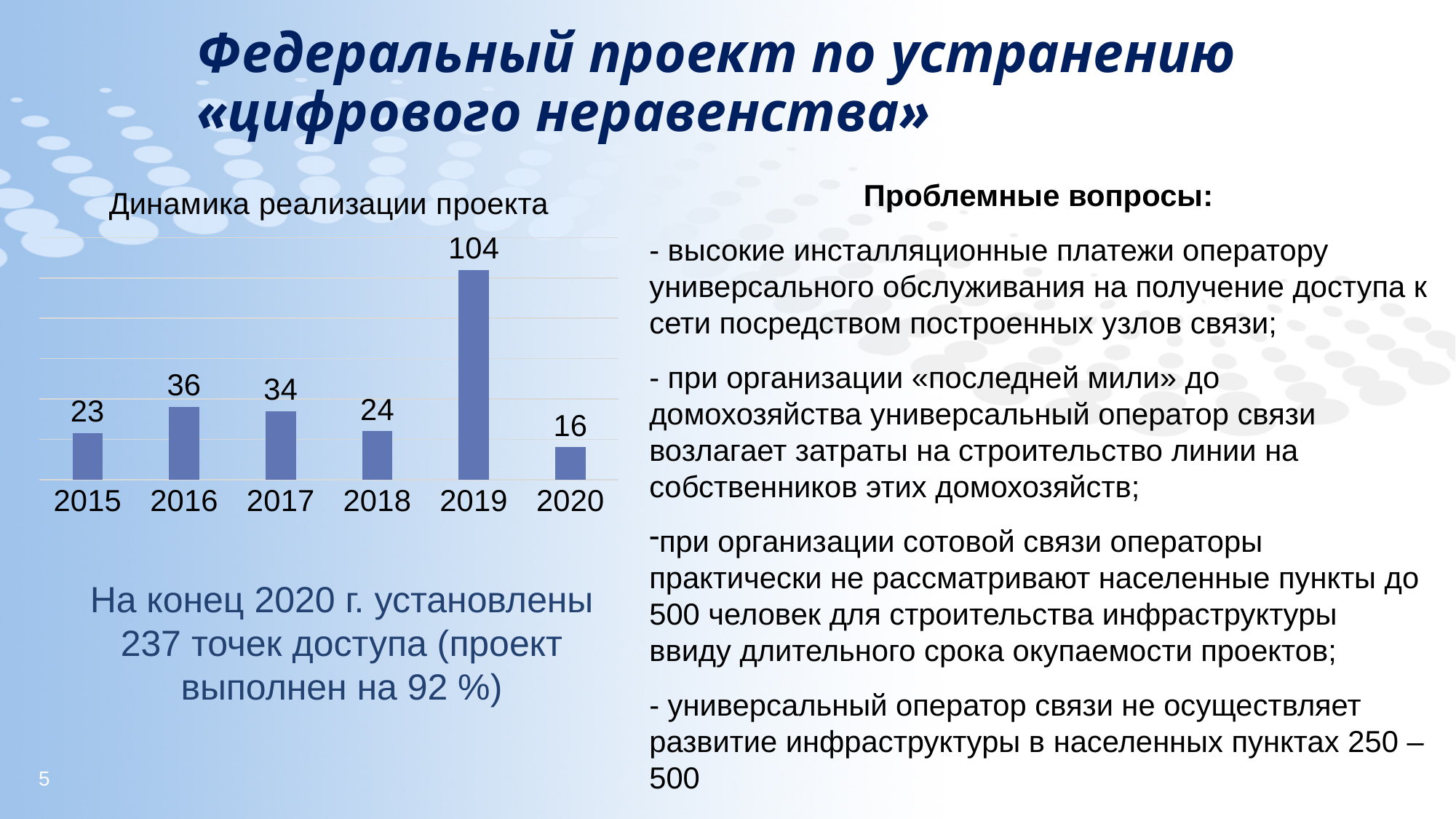
Which year has the lowest value in the chart? 2020 What is the difference between the values for 2019 and 2018? 80 Which is larger, the value for 2016 or the value for 2018? 2016 What is the value for 2019 in the chart? 104 What is the title of the chart? Динамика реализации проекта What is the value for 2020 in the chart? 16 What kind of chart is shown on the slide? Bar chart Which year has the highest value in the chart? 2019 What is the value for 2015 in the chart? 23 What is the total of the values for 2015 and 2016? 59 How many years are shown on the x axis of the chart? 6 What is the difference between the values for 2016 and 2017? 2